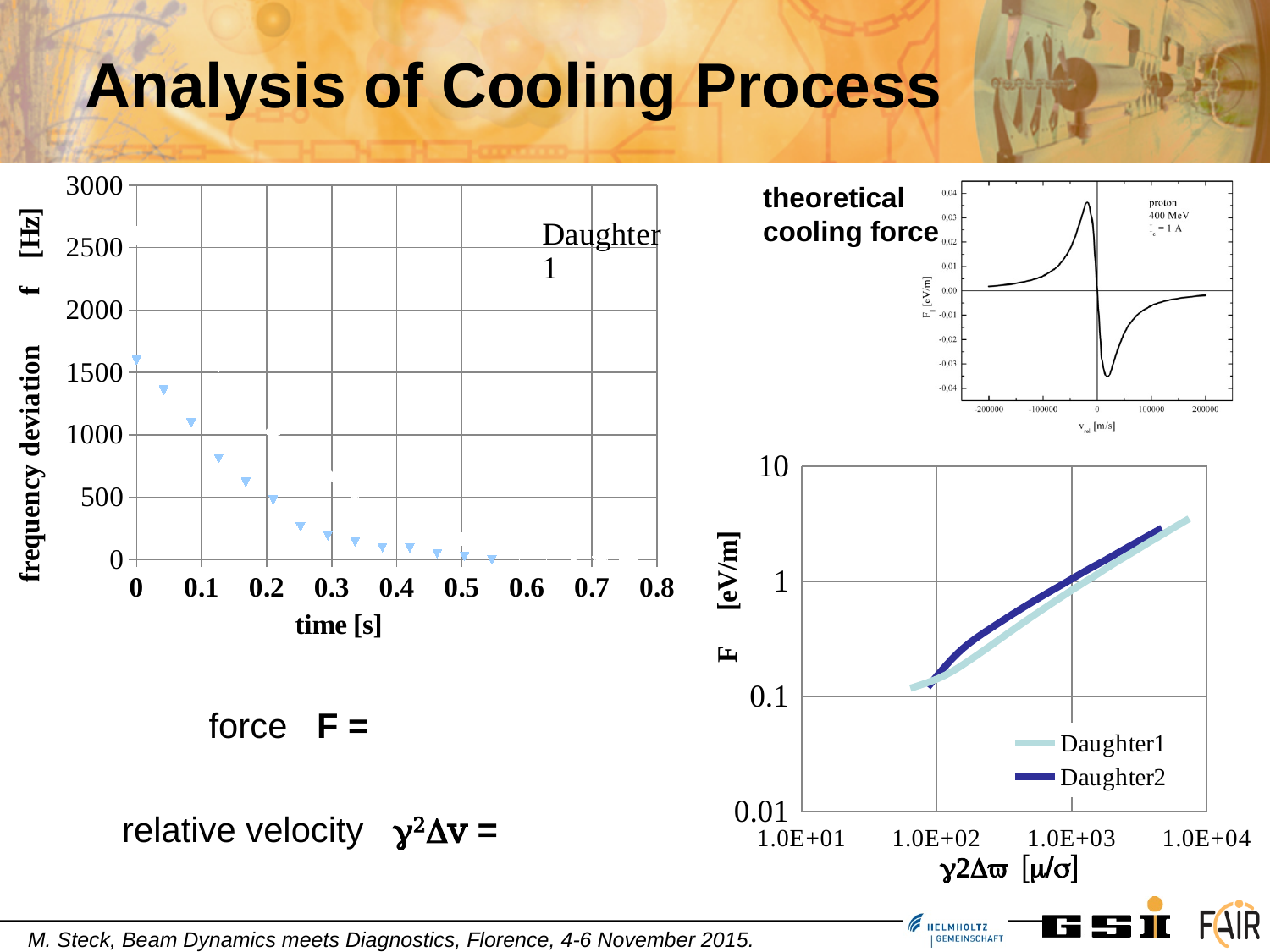
What is the y-axis label of the bottom-right chart? F [eV/m] In the bottom-right chart, between 1.0E+02 and 1.0E+03, which series has the larger F values, Daughter1 or Daughter2? Daughter2 In the left chart, do the frequency deviation values rise or fall as time increases? fall In the left chart, is the frequency deviation at time 0.2 s greater or less than 1000? less In the bottom-right chart, do the F values rise or fall as γ2Δϖ increases? rise What kind of chart is the left chart of frequency deviation versus time? scatter chart In the left chart, is the frequency deviation at time 0 greater or less than 1000? greater What is the largest value shown on the time axis of the left chart? 0.8 How many series does the legend of the bottom-right chart (F versus γ2Δϖ) list? 2 In the left chart, is the frequency deviation at time 0.5 s greater or less than 500? less What kind of chart is the bottom-right chart of F versus γ2Δϖ? line chart